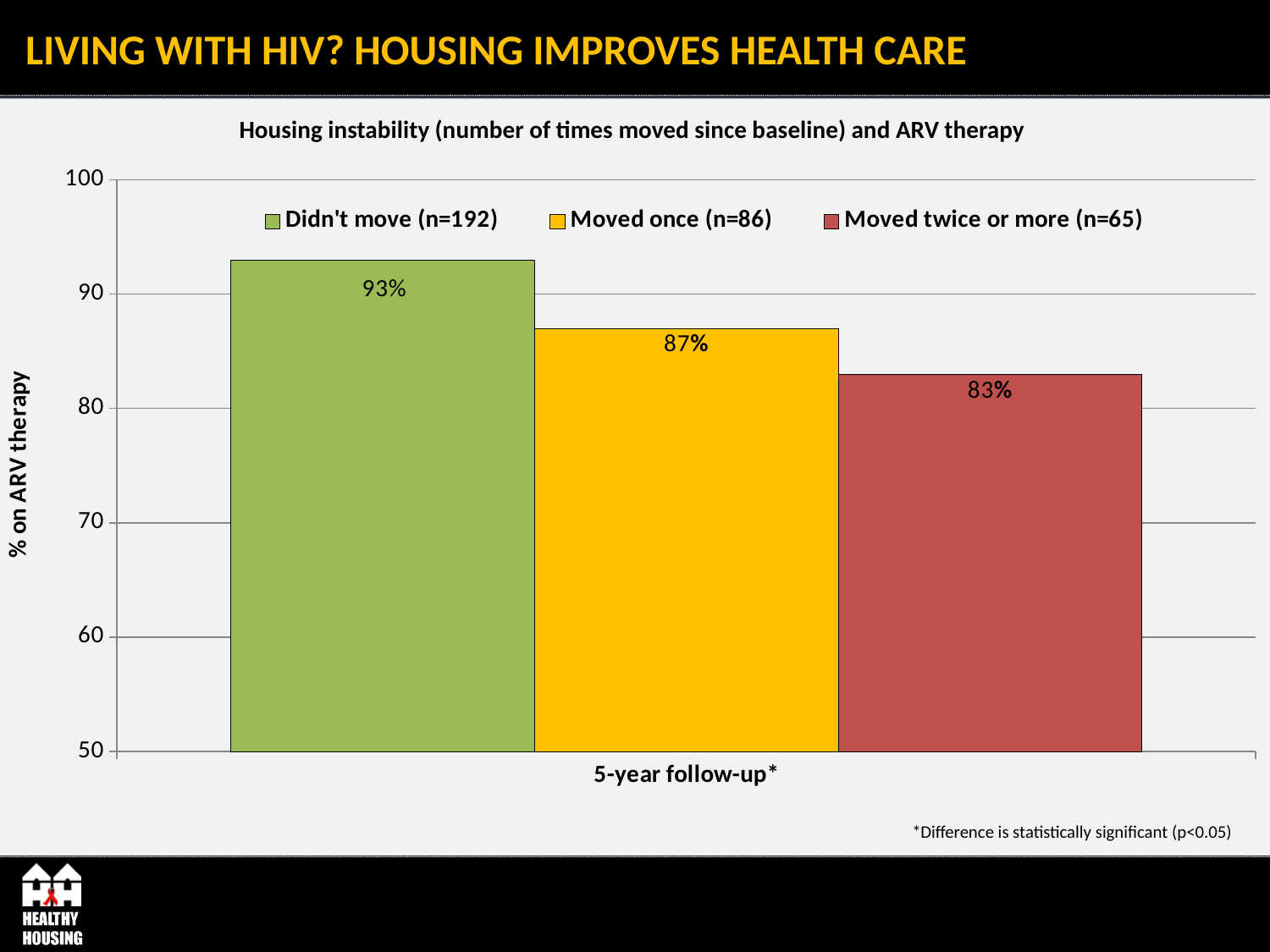
What is the title of the chart? Housing instability (number of times moved since baseline) and ARV therapy What is the difference in percentage points between the 'Didn't move' group and the 'Moved once' group? 6 What percentage of the 'Moved once (n=86)' group was on ARV therapy at 5-year follow-up? 87% What is the difference in percentage points between the 'Didn't move' group and the 'Moved twice or more' group? 10 Which is larger: the value for 'Moved once' or the value for 'Moved twice or more'? Moved once How many series does the legend list? 3 What percentage of the 'Didn't move (n=192)' group was on ARV therapy at 5-year follow-up? 93% Which group has the lowest percentage on ARV therapy? Moved twice or more (n=65) Is the value for 'Moved twice or more' greater or less than 90? less Which group has the highest percentage on ARV therapy? Didn't move (n=192) What percentage of the 'Moved twice or more (n=65)' group was on ARV therapy at 5-year follow-up? 83% What kind of chart is shown on the slide? Bar chart